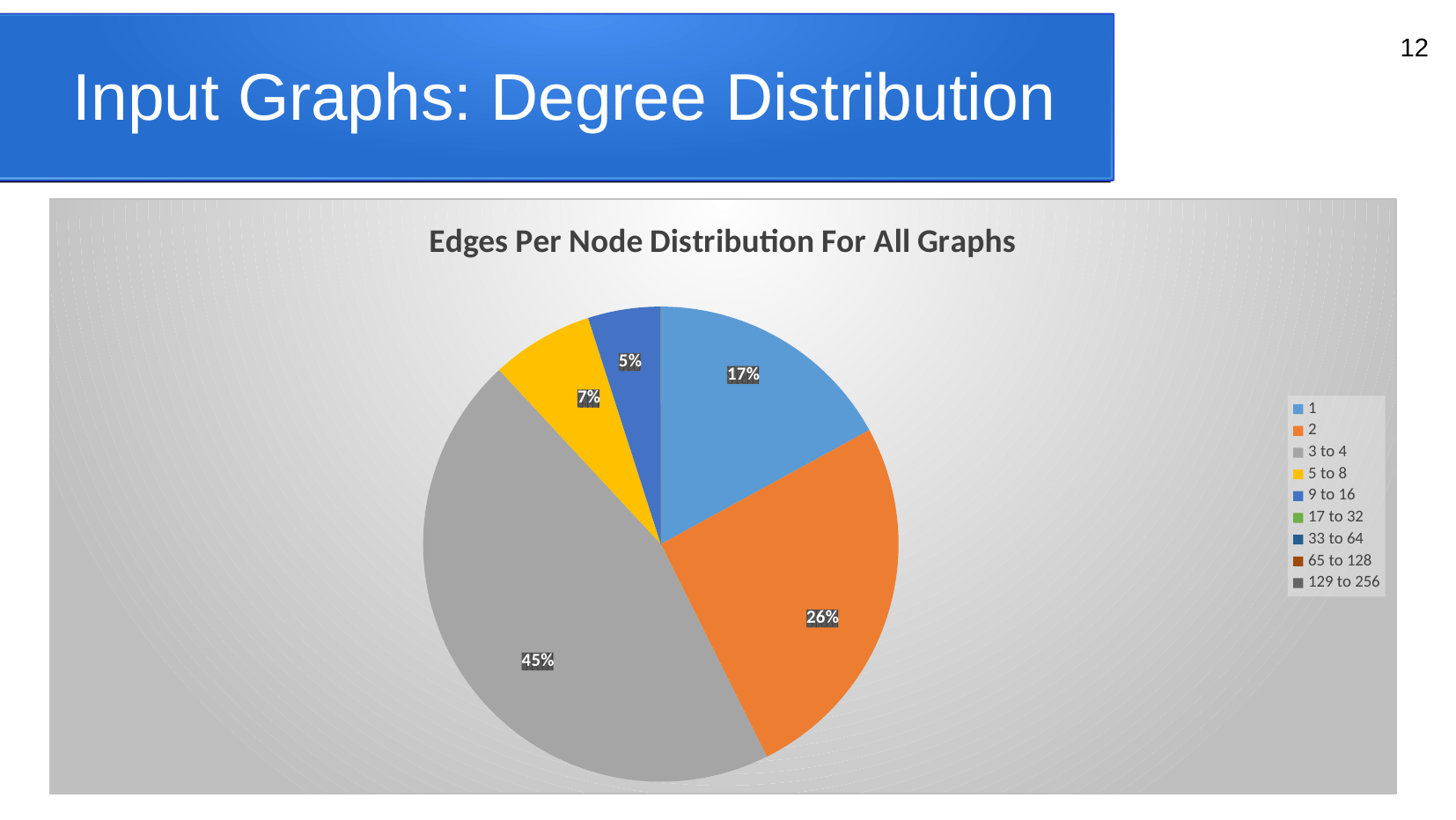
What percentage of the pie is the "2" slice? 26% Which category has the largest slice of the pie? 3 to 4 What percentage of the pie is the "3 to 4" slice? 45% What percentage of the pie is the "5 to 8" slice? 7% What is the title of the chart? Edges Per Node Distribution For All Graphs What percentage of the pie is the "9 to 16" slice? 5% How many entries does the legend list? 9 Which slice is larger, "1" or "2"? 2 Among the labelled slices, which category has the smallest share? 9 to 16 What is the difference in percentage points between the "3 to 4" slice and the "2" slice? 19 What percentage of the pie is the "1" slice? 17% What type of chart is shown on the slide? pie chart